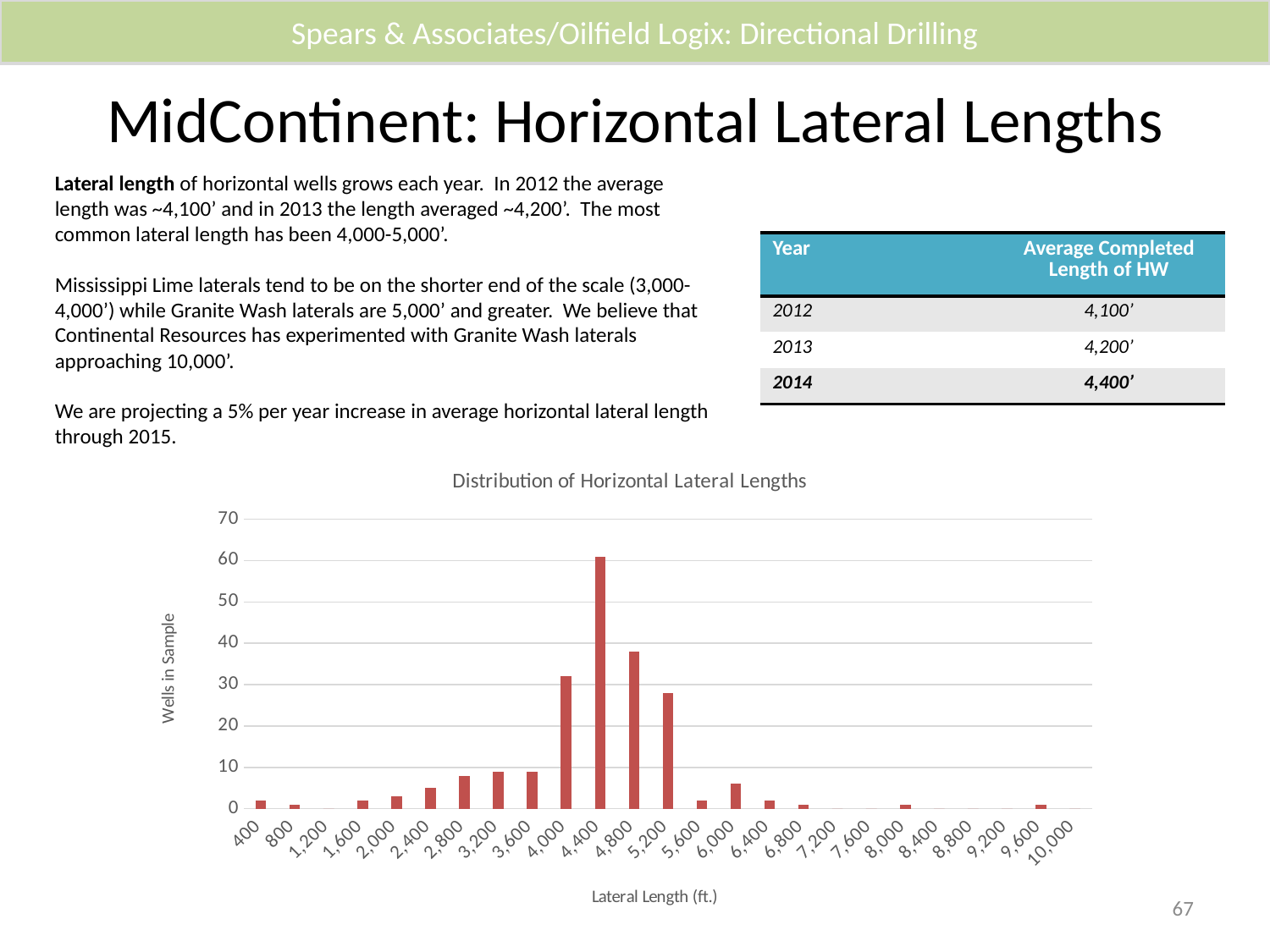
What kind of chart is 'Distribution of Horizontal Lateral Lengths'? bar chart Is the number of wells for a lateral length of 4,000 greater or less than 20? greater Is the number of wells for a lateral length of 4,400 greater or less than 50? greater Which has more wells in the sample: a lateral length of 4,000 or 6,000? 4,000 Which lateral length has the highest number of wells in the sample? 4,400 Is the number of wells for a lateral length of 2,000 greater or less than 10? less How many lateral length categories are shown on the x axis? 25 Do the bar values rise or fall from a lateral length of 4,400 to 6,000? fall What is the label of the vertical axis of the chart? Wells in Sample Which has more wells in the sample: a lateral length of 4,400 or 4,800? 4,400